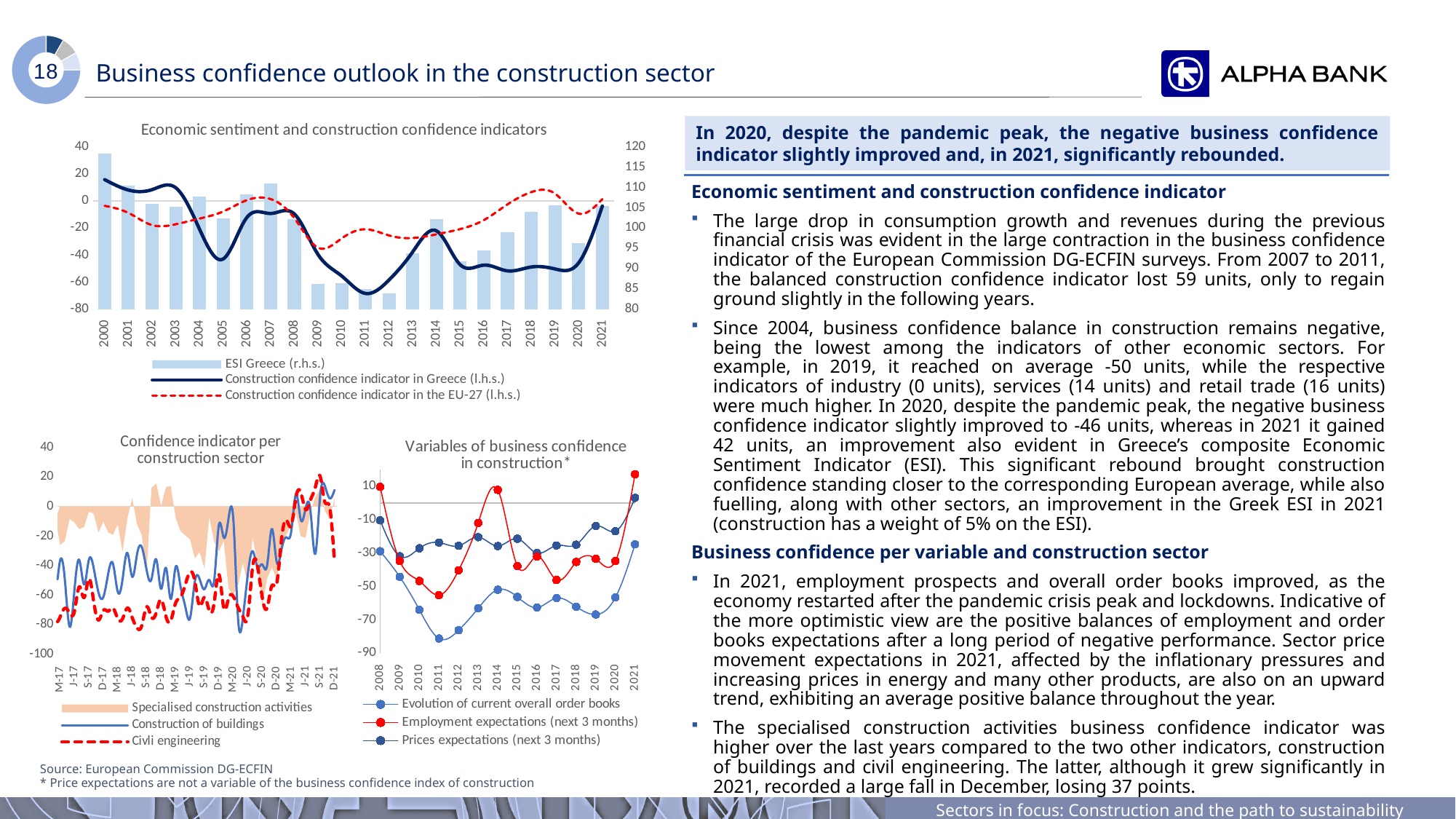
In the chart titled 'Economic sentiment and construction confidence indicators', is the value of the construction confidence indicator in Greece in 2011 greater or less than -60? less In the chart titled 'Variables of business confidence in construction', is the value of the evolution of current overall order books in 2011 greater or less than -70? less In the chart titled 'Economic sentiment and construction confidence indicators', is the value of the construction confidence indicator in the EU-27 in 2018 greater or less than 0? greater In the chart titled 'Variables of business confidence in construction', how many years are shown on the x axis? 14 In the chart titled 'Economic sentiment and construction confidence indicators', does the construction confidence indicator in Greece rise or fall from 2019 to 2021? rise In the chart titled 'Variables of business confidence in construction', in which year is the evolution of current overall order books series at its lowest? 2011 In the chart titled 'Confidence indicator per construction sector', how many series does the legend list? 3 In the chart titled 'Variables of business confidence in construction', in which year is the employment expectations series at its highest? 2021 In the chart titled 'Economic sentiment and construction confidence indicators', how many years are shown on the x axis? 22 In the chart titled 'Variables of business confidence in construction', which is larger in 2021: employment expectations or evolution of current overall order books? Employment expectations In the chart titled 'Economic sentiment and construction confidence indicators', which series is drawn as bars? ESI Greece (r.h.s.) In the chart titled 'Economic sentiment and construction confidence indicators', how many series does the legend list? 3